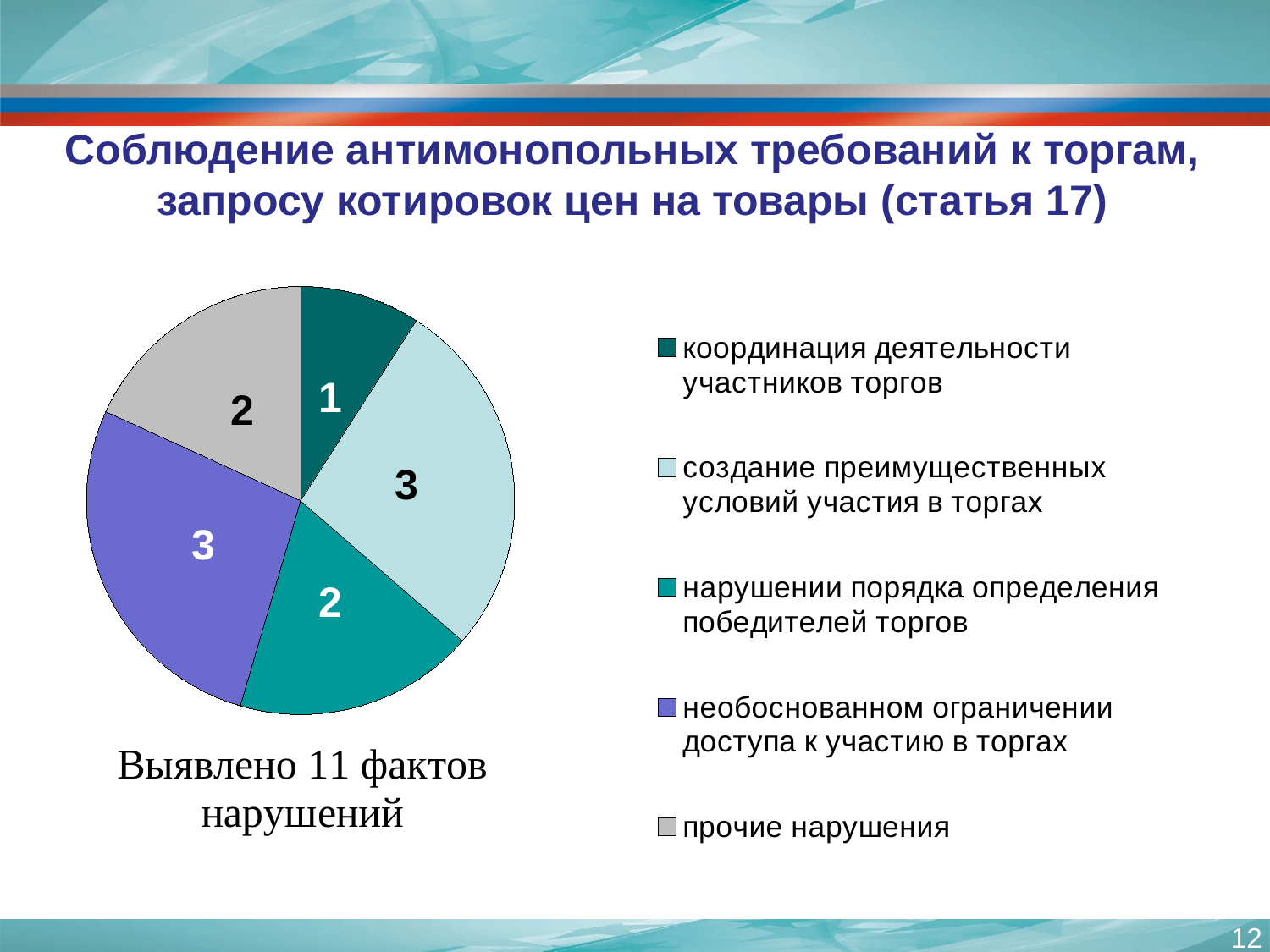
How many slices does the pie chart have? 5 What is the total of all slices in the pie chart? 11 What type of chart is shown on the slide? pie chart What is the value for "координация деятельности участников торгов"? 1 What is the value for "нарушении порядка определения победителей торгов"? 2 Which is larger: "необоснованном ограничении доступа к участию в торгах" or "прочие нарушения"? необоснованном ограничении доступа к участию в торгах What is the value for "прочие нарушения"? 2 Which category has the smallest slice in the pie chart? координация деятельности участников торгов What colour is the slice for "прочие нарушения"? grey What is the difference between the values for "создание преимущественных условий участия в торгах" and "координация деятельности участников торгов"? 2 What is the value for "создание преимущественных условий участия в торгах"? 3 How many entries does the legend of the pie chart list? 5